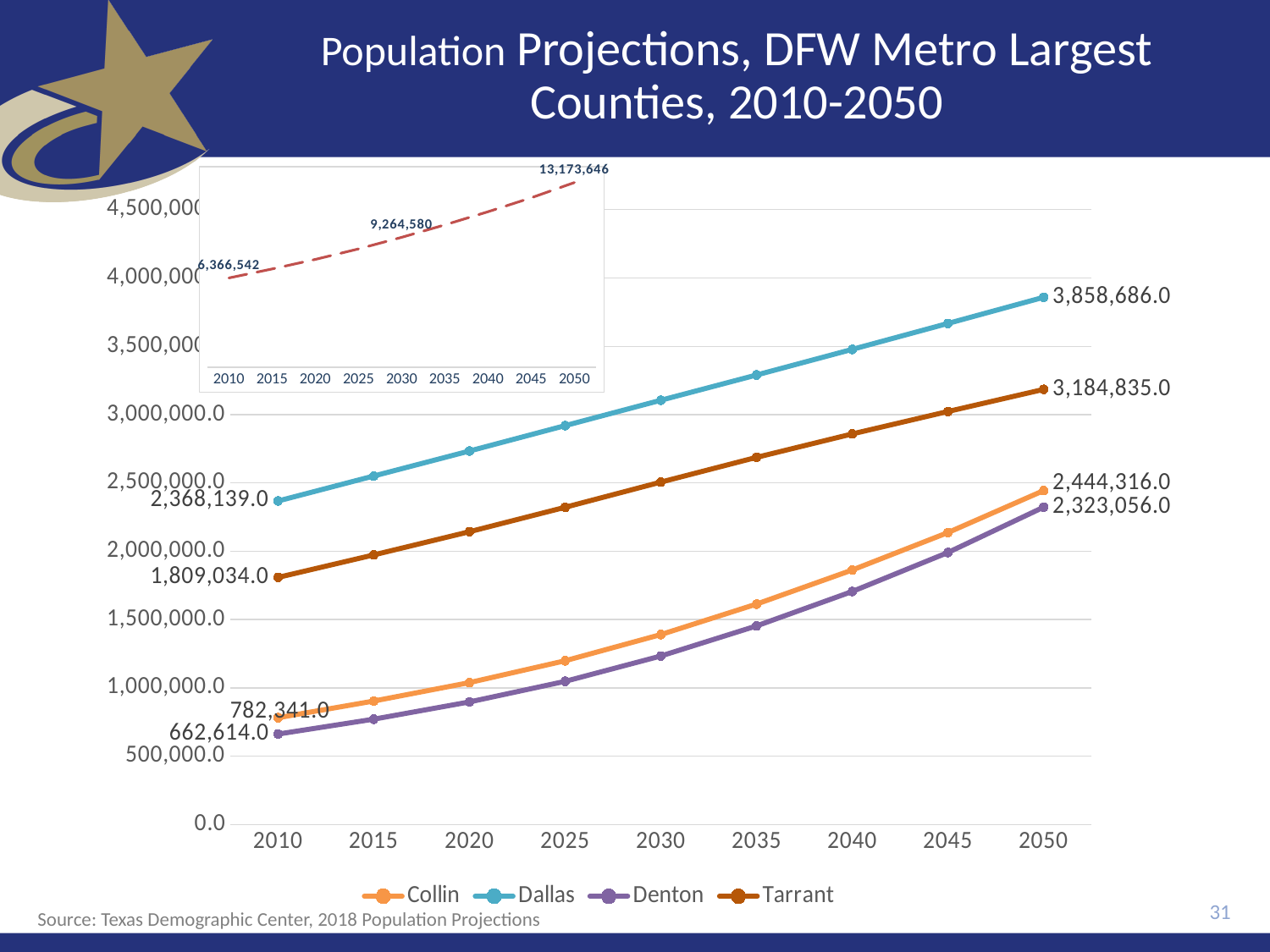
In the small inset chart at the top left, what is the difference between the 2030 value and the 2010 value? 2,898,038 In the main chart, which is larger in 2050: the value for Collin or the value for Denton? Collin In the main chart, what is the 2010 population value shown for Tarrant? 1,809,034.0 In the main chart, which county has the lowest population in 2010? Denton In the main chart, what is the 2050 value shown for Denton? 2,323,056.0 In the small inset chart at the top left, what is the value labeled for 2050? 13,173,646 In the main chart, which county has the highest projected population in 2050? Dallas In the main chart, by how much is Collin's population projected to grow between 2010 and 2050? 1,661,975.0 In the main chart, is the value for Tarrant in 2030 greater or less than 2,000,000.0? greater In the main chart, what is the projected population of Dallas County in 2050? 3,858,686.0 How many series does the legend of the main chart list? 4 What kind of chart is the main chart on the slide? Line chart